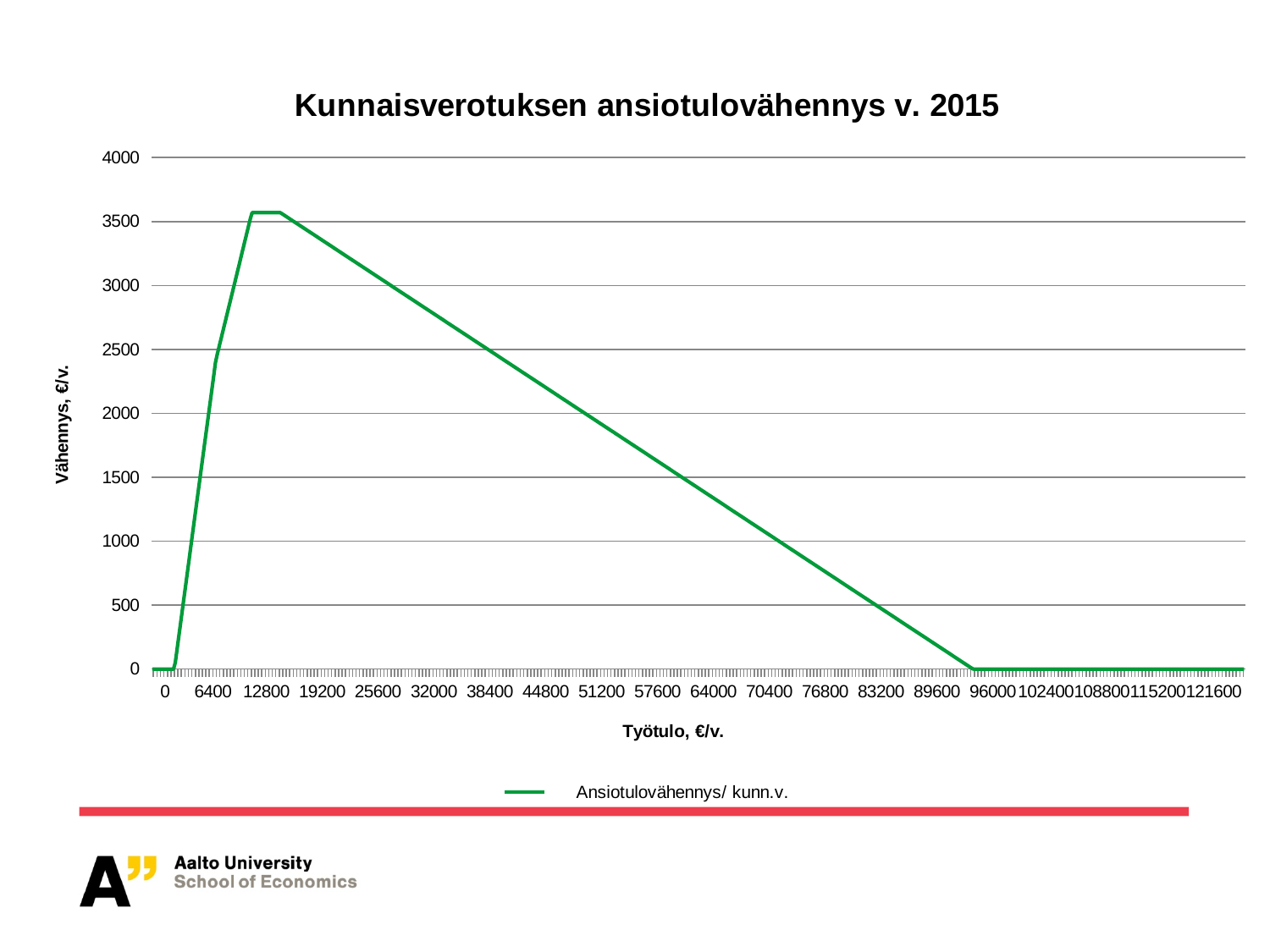
Is the value at a Työtulo of 76800 greater or less than 1000? less What is the value of the line at a Työtulo of 0? 0 How many series does the legend list? 1 Is the value at a Työtulo of 32000 greater or less than 2500? greater What is the title of the chart? Kunnaisverotuksen ansiotulovähennys v. 2015 Is the peak value of the line greater or less than 3500? greater What is the legend entry for the plotted line? Ansiotulovähennys/ kunn.v. What kind of chart is shown on the slide? line chart Between a Työtulo of 19200 and 89600, does the line rise or fall? fall What is the value of the line at a Työtulo of 121600? 0 Which is larger: the value at a Työtulo of 25600 or at 70400? 25600